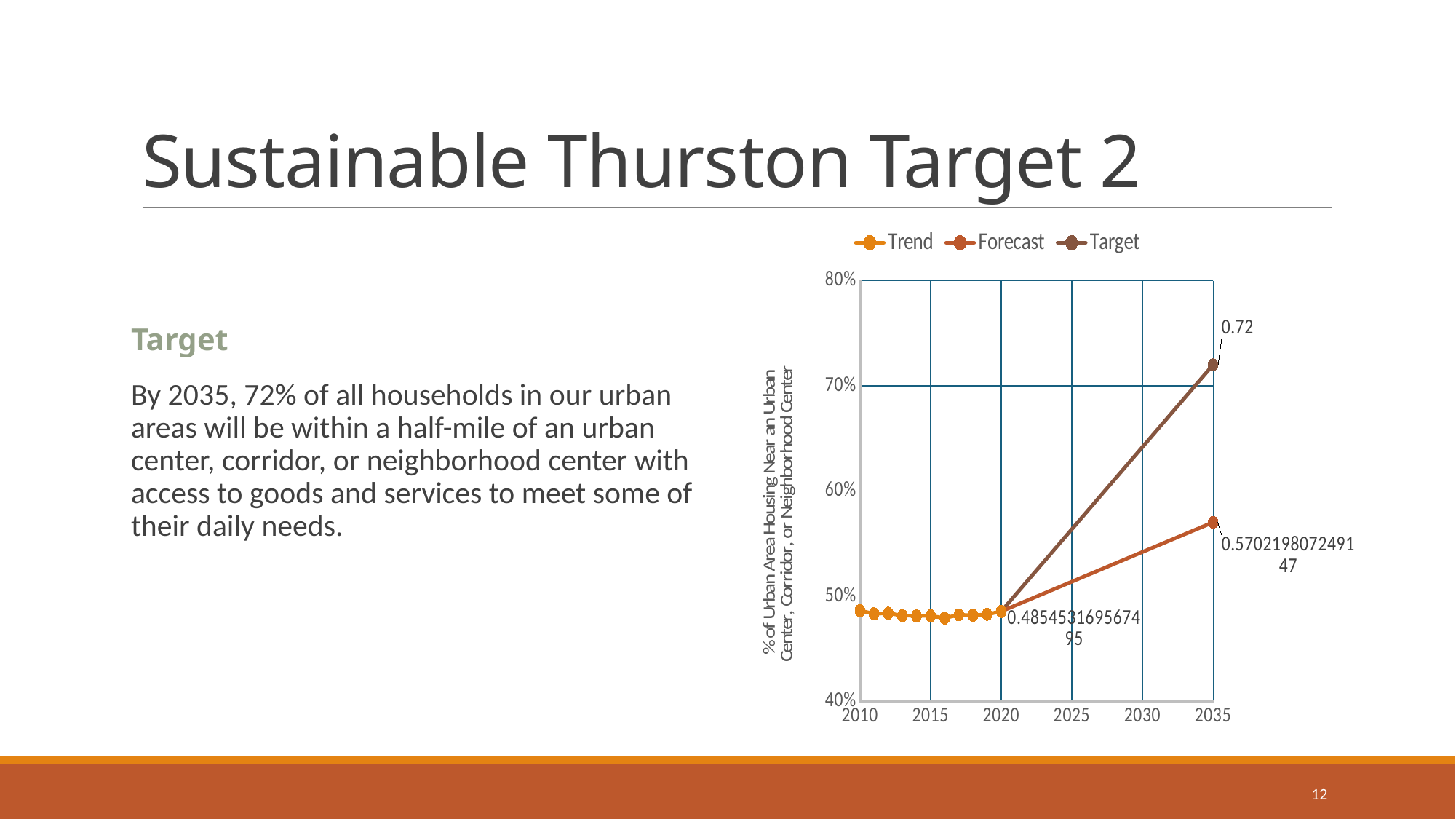
What is the data label shown at the 2020 point where the Trend line ends? 0.485453169567495 What type of chart is shown on the slide? line chart What are the series names listed in the chart legend? Trend, Forecast, Target What is the data label shown for the Forecast series at 2035? 0.570219807249147 Is the Target value at 2035 greater or less than 70%? greater Is the Trend value at 2010 greater or less than 50%? less Which series has the higher value at 2035, Forecast or Target? Target What is the label on the vertical axis of the chart? % of Urban Area Housing Near an Urban Center, Corridor, or Neighborhood Center Is the Forecast value at 2035 greater or less than 60%? less How many series does the chart legend list? 3 Does the Target line rise or fall between 2020 and 2035? rise What is the data label shown for the Target series at 2035? 0.72